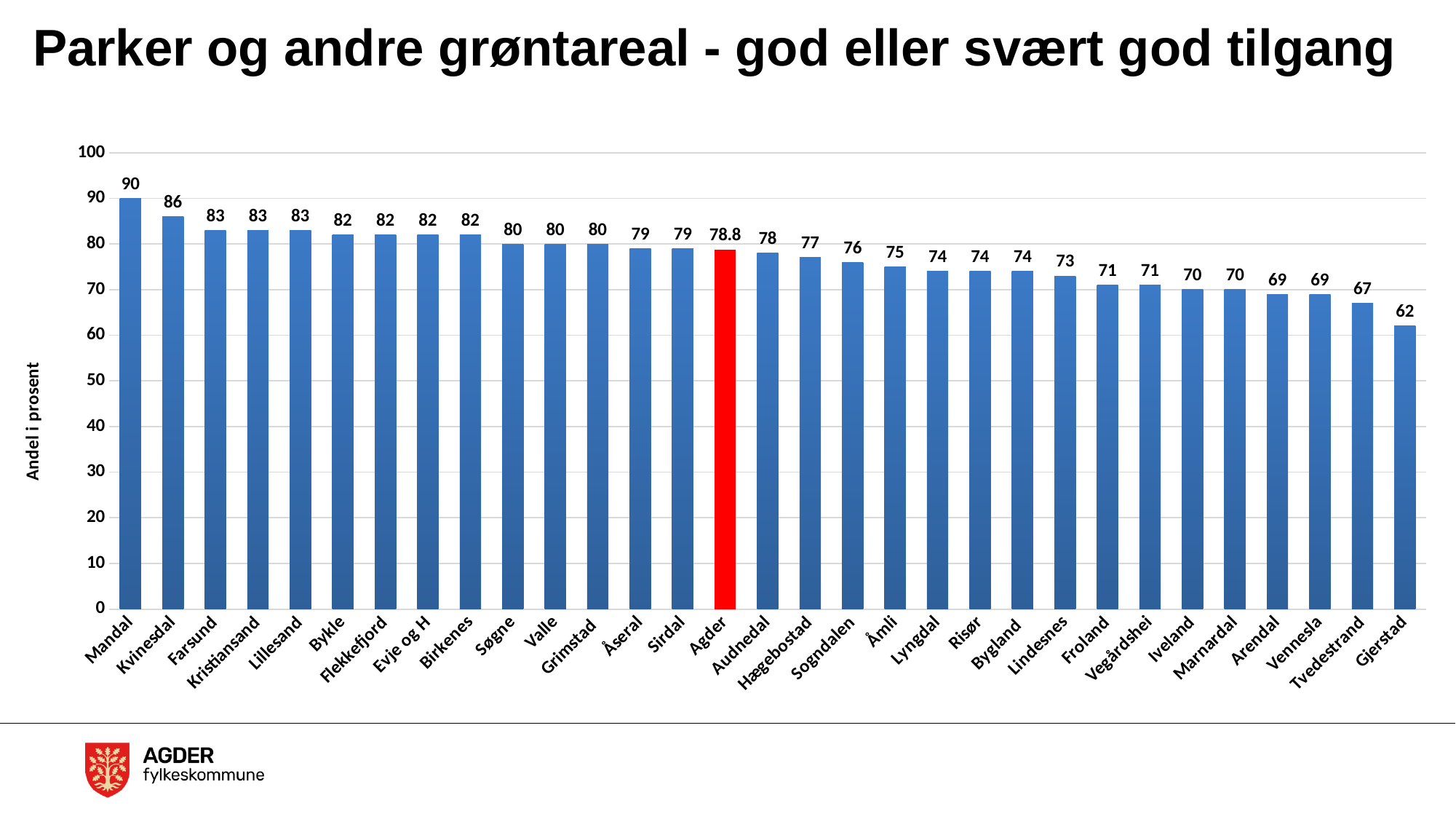
Which category has the highest value? Mandal Which is larger, the value for Farsund or the value for Arendal? Farsund What is the value for Mandal? 90 What is the value for Lindesnes? 73 Do the values rise or fall from left to right along the x axis? Fall How many categories are shown on the x axis? 31 What kind of chart is shown on the slide? Bar chart What is the difference between the values for Mandal and Gjerstad? 28 Which category has the lowest value? Gjerstad What is the value for Agder? 78.8 What is the value for Gjerstad? 62 What is the difference between the values for Kvinesdal and Tvedestrand? 19